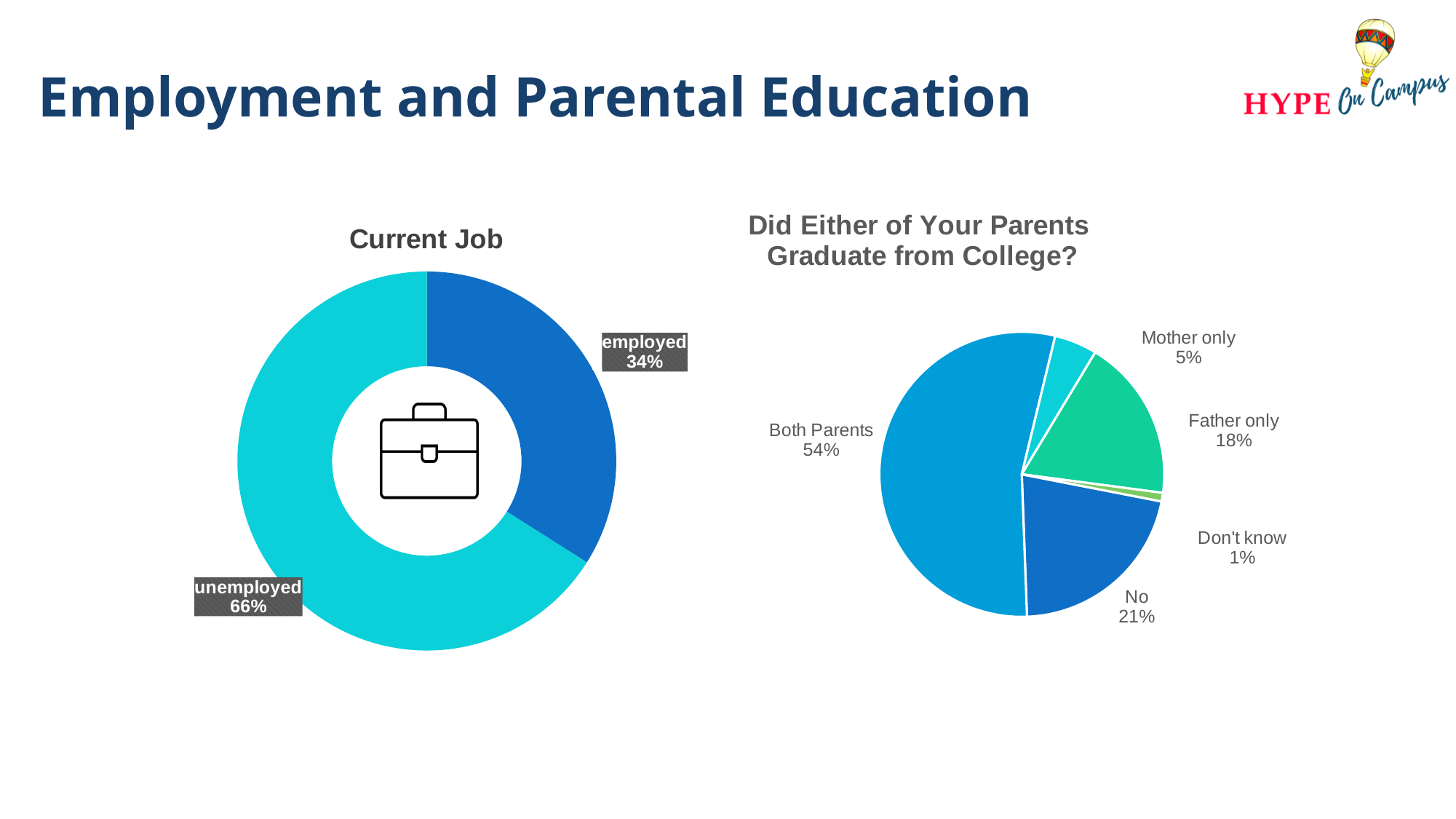
In the 'Current Job' chart, what is the difference in percentage points between unemployed and employed? 32 In the 'Did Either of Your Parents Graduate from College?' chart, what percentage answered 'Father only'? 18% In the 'Did Either of Your Parents Graduate from College?' chart, what is the difference in percentage points between 'No' and 'Father only'? 3 In the 'Did Either of Your Parents Graduate from College?' chart, which is larger: 'Father only' or 'Mother only'? Father only In the 'Did Either of Your Parents Graduate from College?' chart, what percentage answered 'Both Parents'? 54% In the 'Current Job' chart, what percentage of respondents are employed? 34% In the 'Current Job' chart, which category has the larger share? unemployed What kind of chart is the 'Current Job' chart? Doughnut chart In the 'Did Either of Your Parents Graduate from College?' chart, which category has the smallest share? Don't know In the 'Did Either of Your Parents Graduate from College?' chart, how many categories are shown? 5 In the 'Current Job' chart, what percentage of respondents are unemployed? 66% In the 'Did Either of Your Parents Graduate from College?' chart, what percentage answered 'No'? 21%